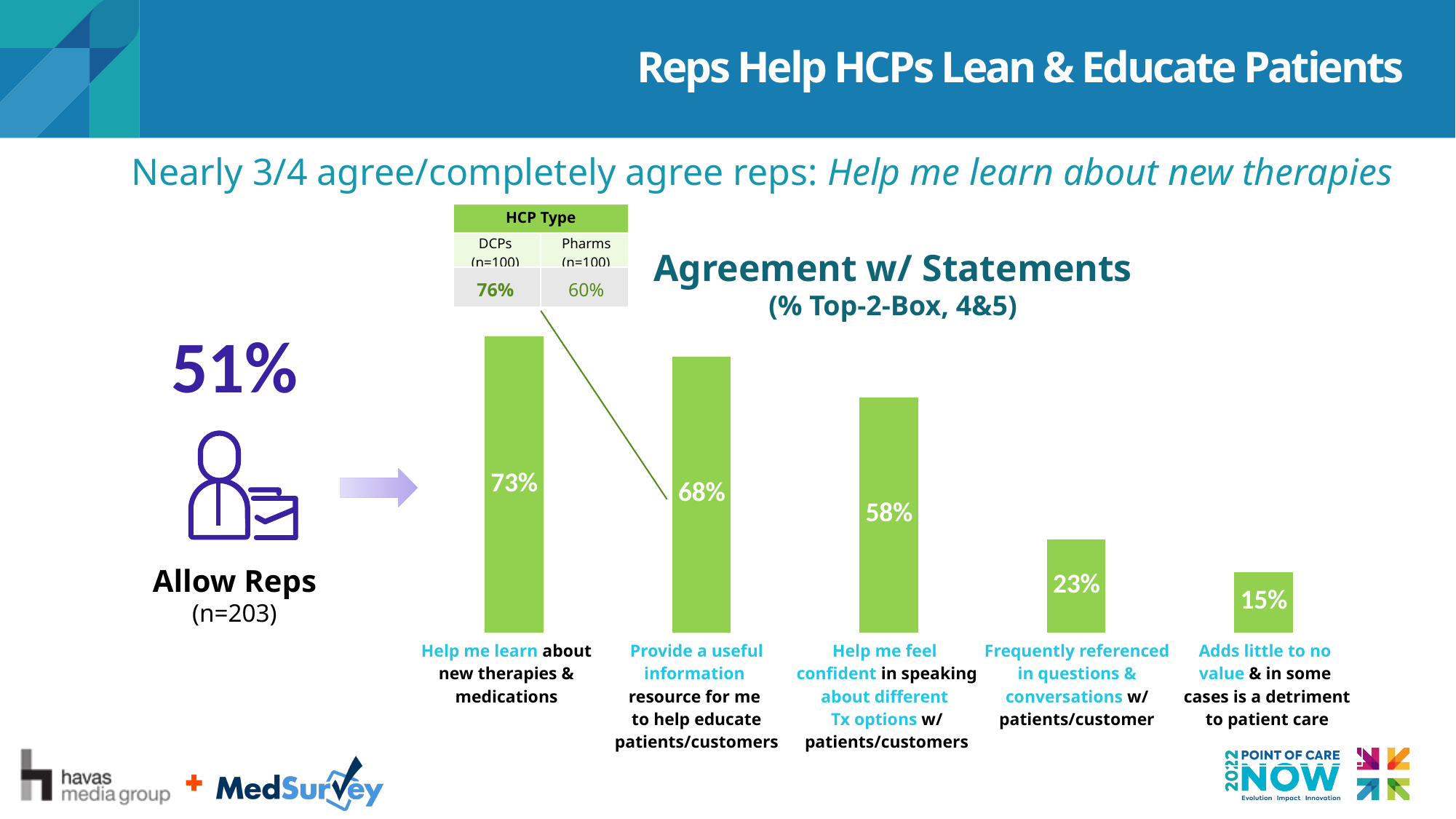
What is the agreement value for 'Provide a useful information resource for me to help educate patients/customers'? 68% What is the value for 'Adds little to no value & in some cases is a detriment to patient care'? 15% Do the bar values rise or fall from left to right across the chart? Fall What is the difference between the agreement for 'Help me learn about new therapies & medications' and 'Frequently referenced in questions & conversations w/ patients/customer'? 50% How many statements are shown as bars in the chart? 5 What type of chart is used to show agreement with statements? Bar chart Which statement has the highest agreement in the chart? Help me learn about new therapies & medications Which has a higher agreement value: 'Provide a useful information resource' or 'Help me feel confident in speaking about different Tx options'? Provide a useful information resource What percentage of respondents agree that reps help them learn about new therapies & medications? 73% What percentage agree that reps help them feel confident in speaking about different Tx options? 58% What is the title of the chart? Agreement w/ Statements Which statement has the lowest agreement in the chart? Adds little to no value & in some cases is a detriment to patient care